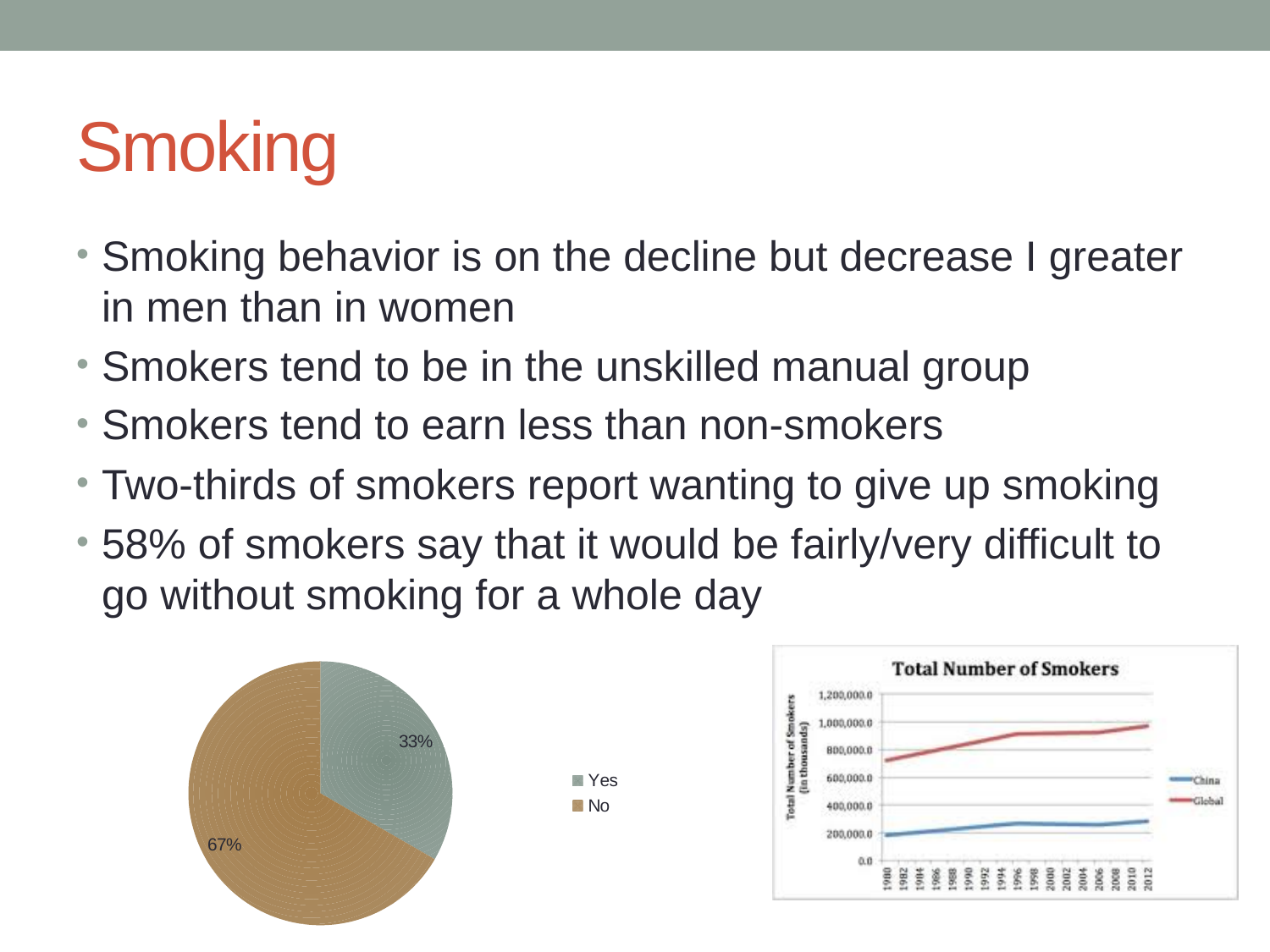
How many series does the legend of the 'Total Number of Smokers' chart list? 2 What is the title of the line chart on the right of the slide? Total Number of Smokers In the 'Total Number of Smokers' chart, is the Global value in 1980 greater or less than 800,000.0? less How many entries does the legend of the pie chart on the left list? 2 In the 'Total Number of Smokers' chart, does the Global line rise or fall from 1980 to 2012? Rise What kind of chart is the 'Total Number of Smokers' chart? Line chart In the pie chart on the left, which category has the larger share? No In the pie chart on the left, what percentage is shown for the Yes slice? 33% In the pie chart on the left, what is the difference in percentage points between the No and Yes slices? 34% In the pie chart on the left, what percentage is shown for the No slice? 67% In the 'Total Number of Smokers' chart, which series is higher in 2012, China or Global? Global What kind of chart is the chart on the left of the slide? Pie chart